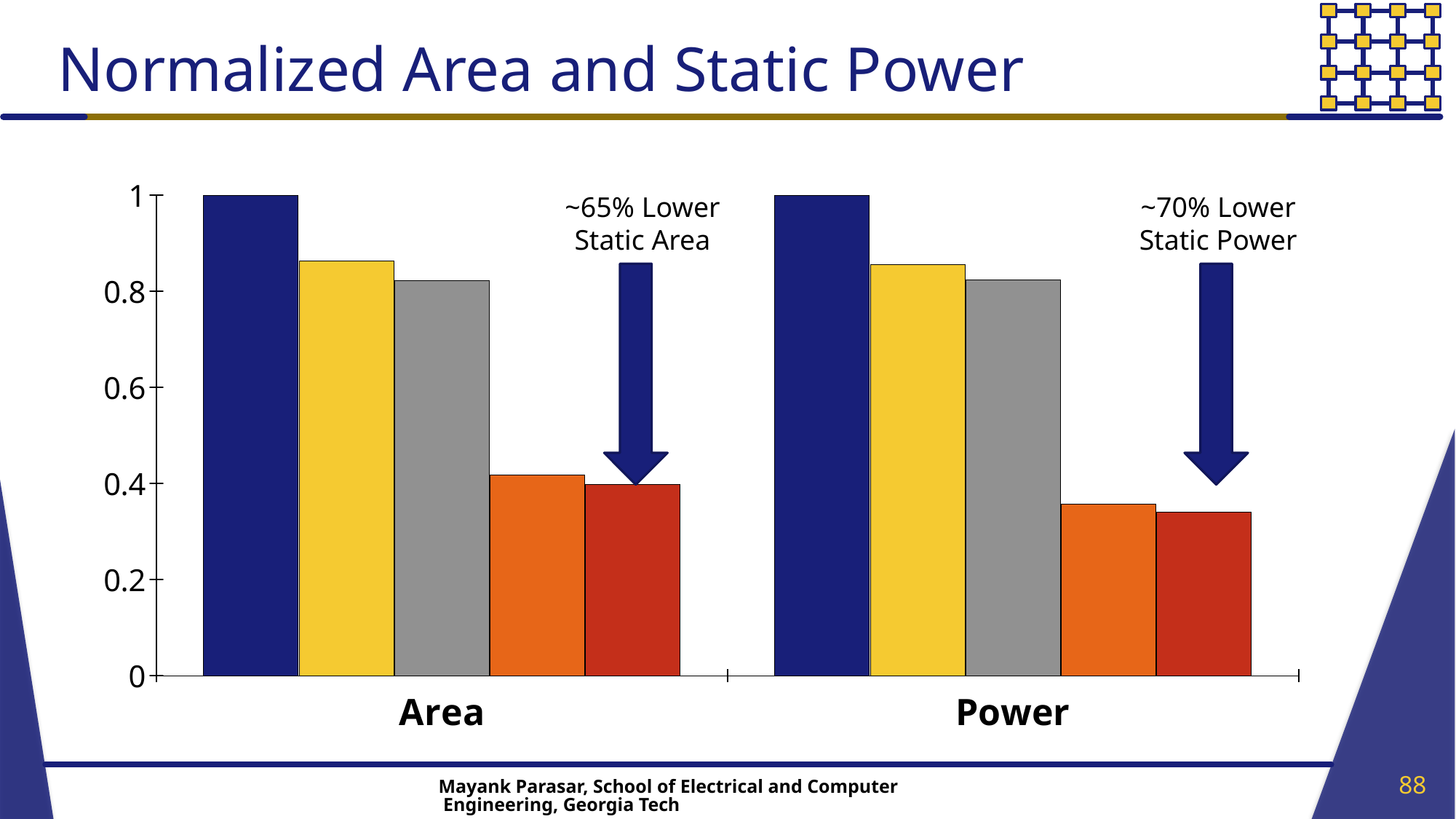
What is the value of the dark blue bar in the Power group? 1 Within the Power group, do the bars rise or fall from left to right? fall Is the value of the red bar in the Power group greater or less than 0.4? less Is the value of the orange bar in the Power group greater or less than 0.4? less How many categories are shown on the x axis of the chart? 2 What is the value of the dark blue bar in the Area group? 1 In the Area group, which is larger: the dark blue bar or the red bar? the dark blue bar How many bars are plotted in the Area group? 5 What reduction does the annotation above the Power group state? ~70% Lower Static Power Is the value of the yellow bar in the Area group greater or less than 0.8? greater What kind of chart is shown on the slide? bar chart Which bar is the highest in the Power group? the dark blue bar